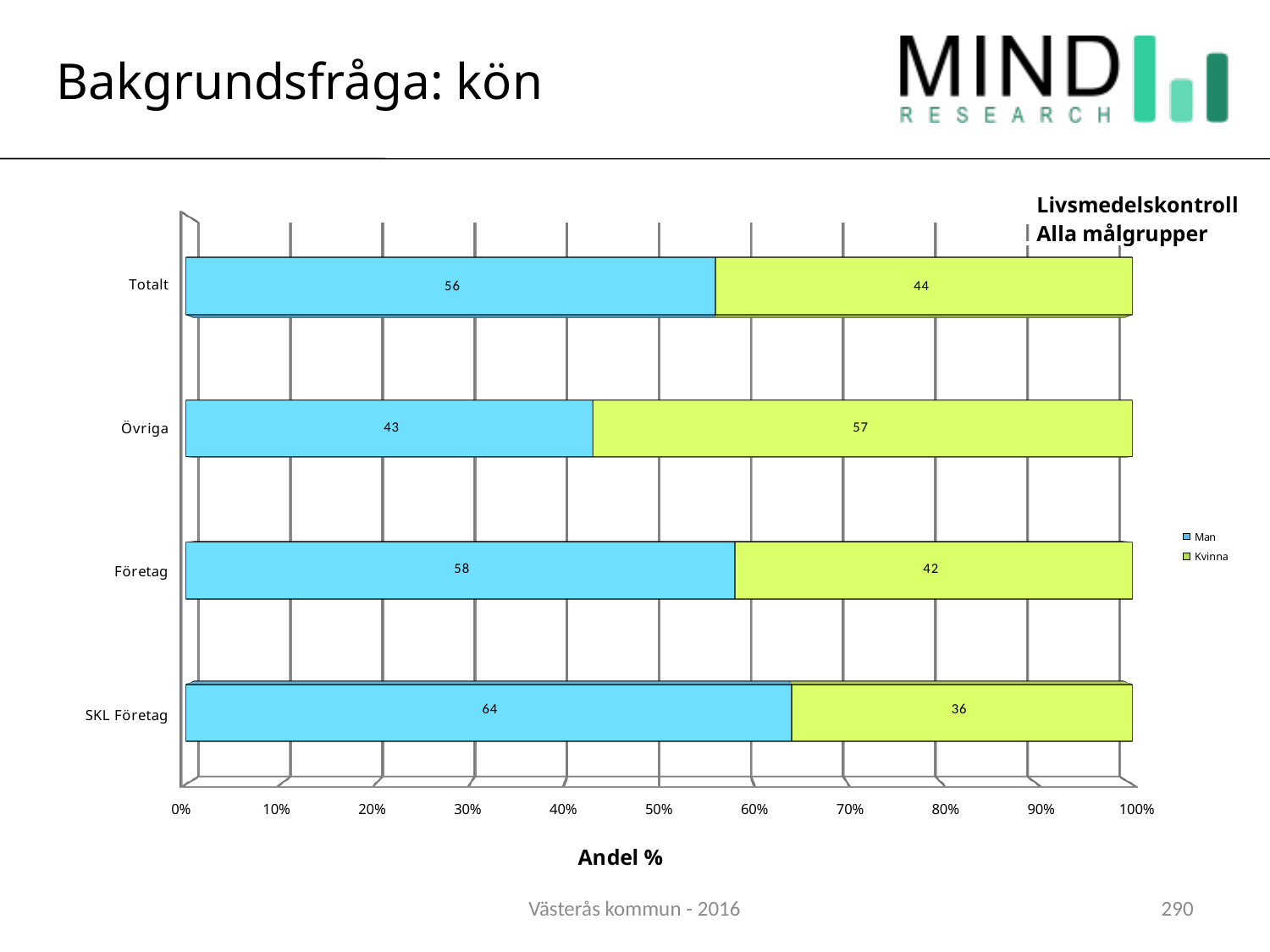
How many series does the legend list? 2 What is the label of the x axis? Andel % Which category has the lowest value for Kvinna? SKL Företag Which category has the highest value for Man? SKL Företag Which is larger: the Man value for Företag or the Man value for Totalt? Företag What kind of chart is shown on the slide? Stacked bar chart What is the difference between the Man value for SKL Företag and the Man value for Övriga? 21 How many categories are shown on the y axis? 4 What is the value for Kvinna in the Företag category? 42 What is the value for Kvinna in the Övriga category? 57 What is the value for Man in the Totalt category? 56 What is the value for Man in the SKL Företag category? 64